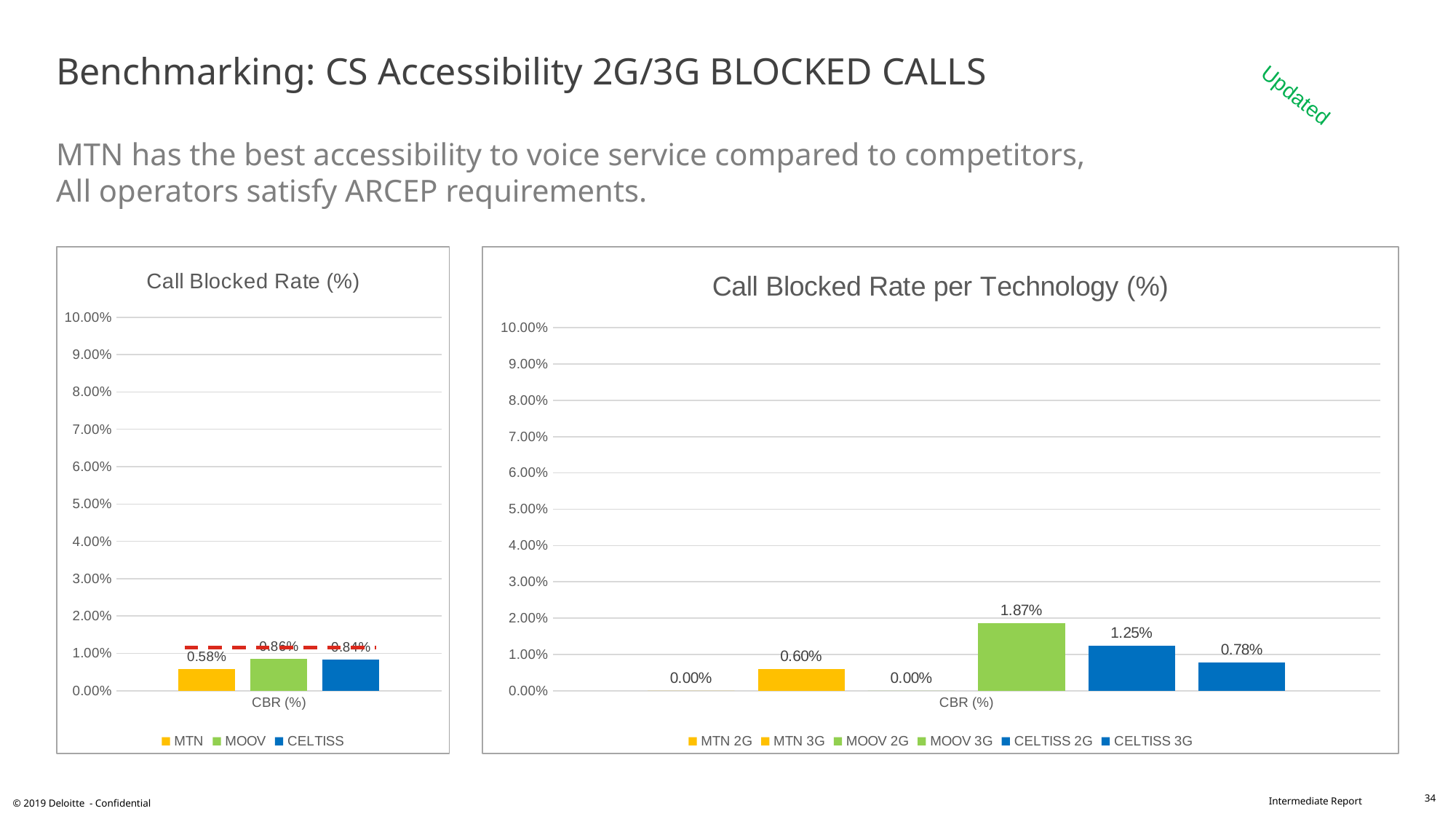
How many series does the legend of the Call Blocked Rate per Technology (%) chart list? 6 In the Call Blocked Rate per Technology (%) chart, what is the difference between the MOOV 3G and CELTISS 2G values? 0.62% In the Call Blocked Rate (%) chart on the left, what is the value for MTN? 0.58% How many series does the legend of the Call Blocked Rate (%) chart on the left list? 3 In the Call Blocked Rate (%) chart on the left, which operator has the lowest call blocked rate? MTN In the Call Blocked Rate per Technology (%) chart, which series has the highest value? MOOV 3G What kind of chart is the Call Blocked Rate (%) chart on the left? bar chart In the Call Blocked Rate (%) chart on the left, is the value for MTN greater or less than 1.00%? less In the Call Blocked Rate per Technology (%) chart, what is the value for CELTISS 2G? 1.25% In the Call Blocked Rate per Technology (%) chart, what is the value for MTN 3G? 0.60% In the Call Blocked Rate per Technology (%) chart, which is larger, CELTISS 2G or CELTISS 3G? CELTISS 2G In the Call Blocked Rate per Technology (%) chart, what is the value for MOOV 3G? 1.87%